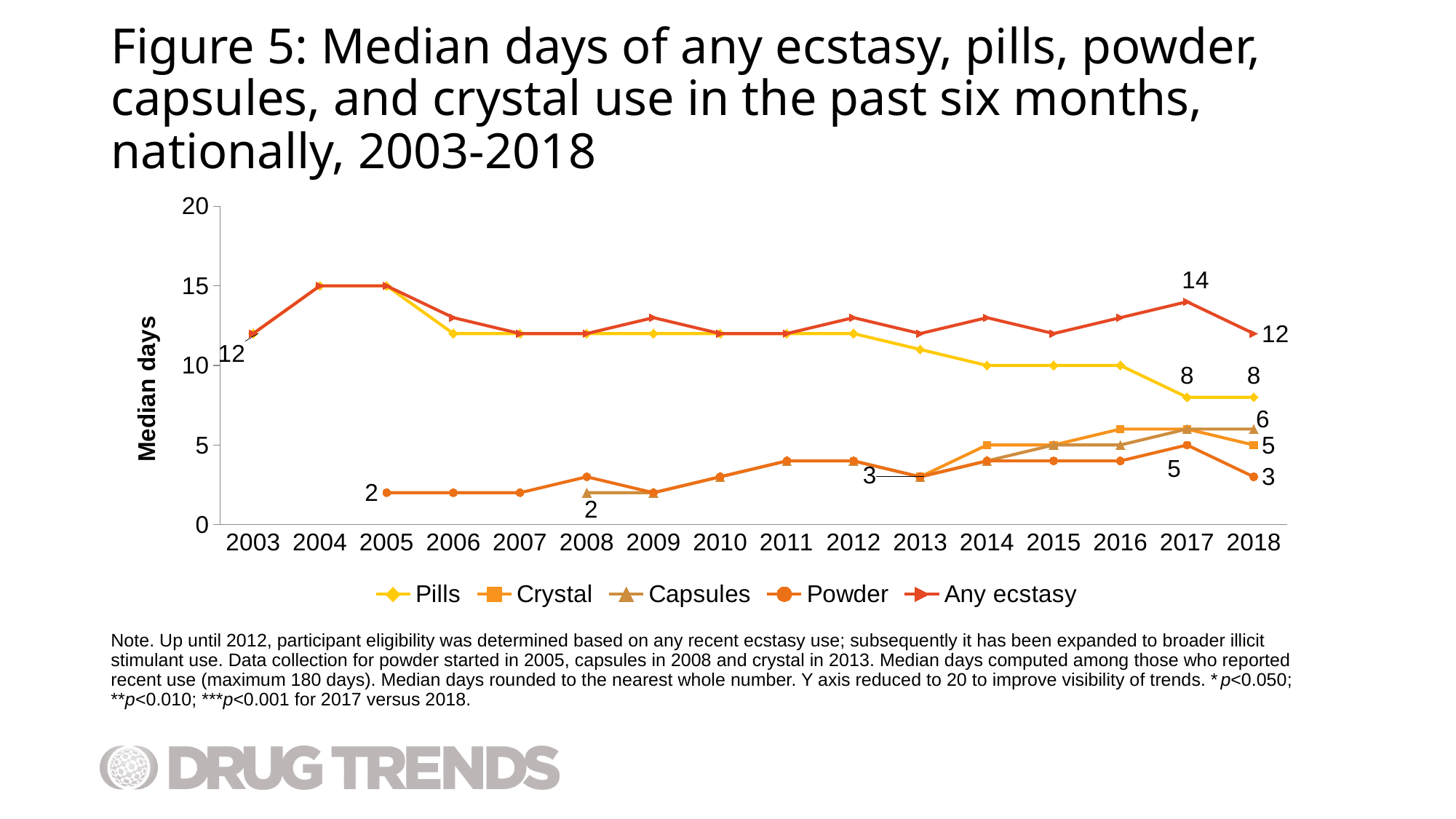
How many years are shown on the x axis? 16 What is the median days value for Powder in 2018? 3 In 2018, which is larger: the value for Pills or the value for Capsules? Pills What is the median days value for Capsules in 2018? 6 What is the median days value for Pills in 2018? 8 What is the median days value for Any ecstasy in 2017? 14 By how much did the Any ecstasy value fall from 2017 to 2018? 2 What is the median days value for Any ecstasy in 2018? 12 Which series has the highest value in 2018? Any ecstasy What kind of chart is shown on the slide? line chart How many series does the legend list? 5 Is the value for Any ecstasy in 2004 greater or less than 10? greater